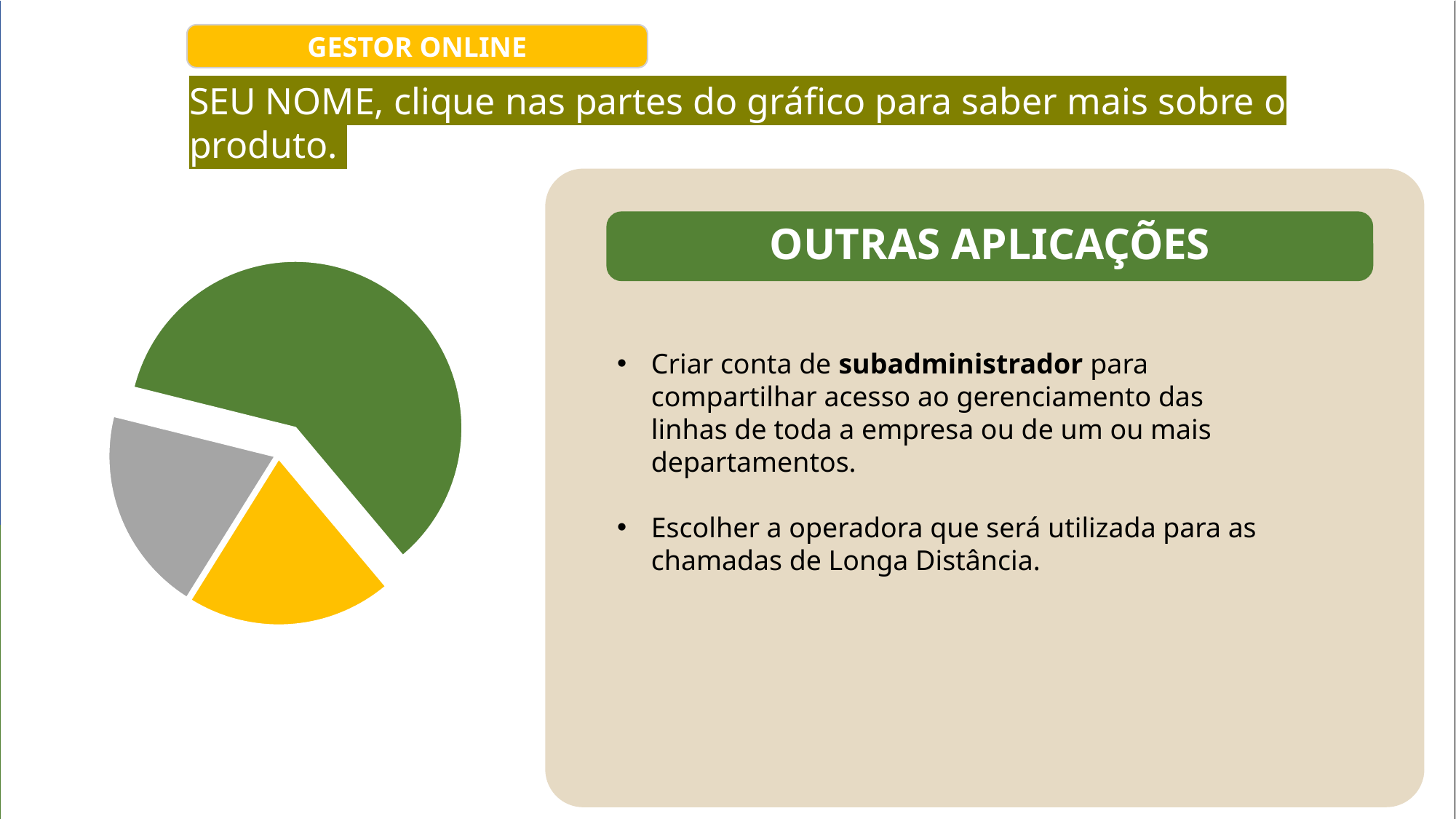
How many slices does the pie chart have? 3 Does the green slice take up more or less than half of the pie chart? more Which slice of the pie chart is the largest? the green slice What colours are the slices of the pie chart? green, gray and yellow What kind of chart is shown on the left of the slide? pie chart Does the pie chart display a legend? No Which is larger in the pie chart, the green slice or the gray slice? the green slice Which is larger in the pie chart, the green slice or the yellow slice? the green slice